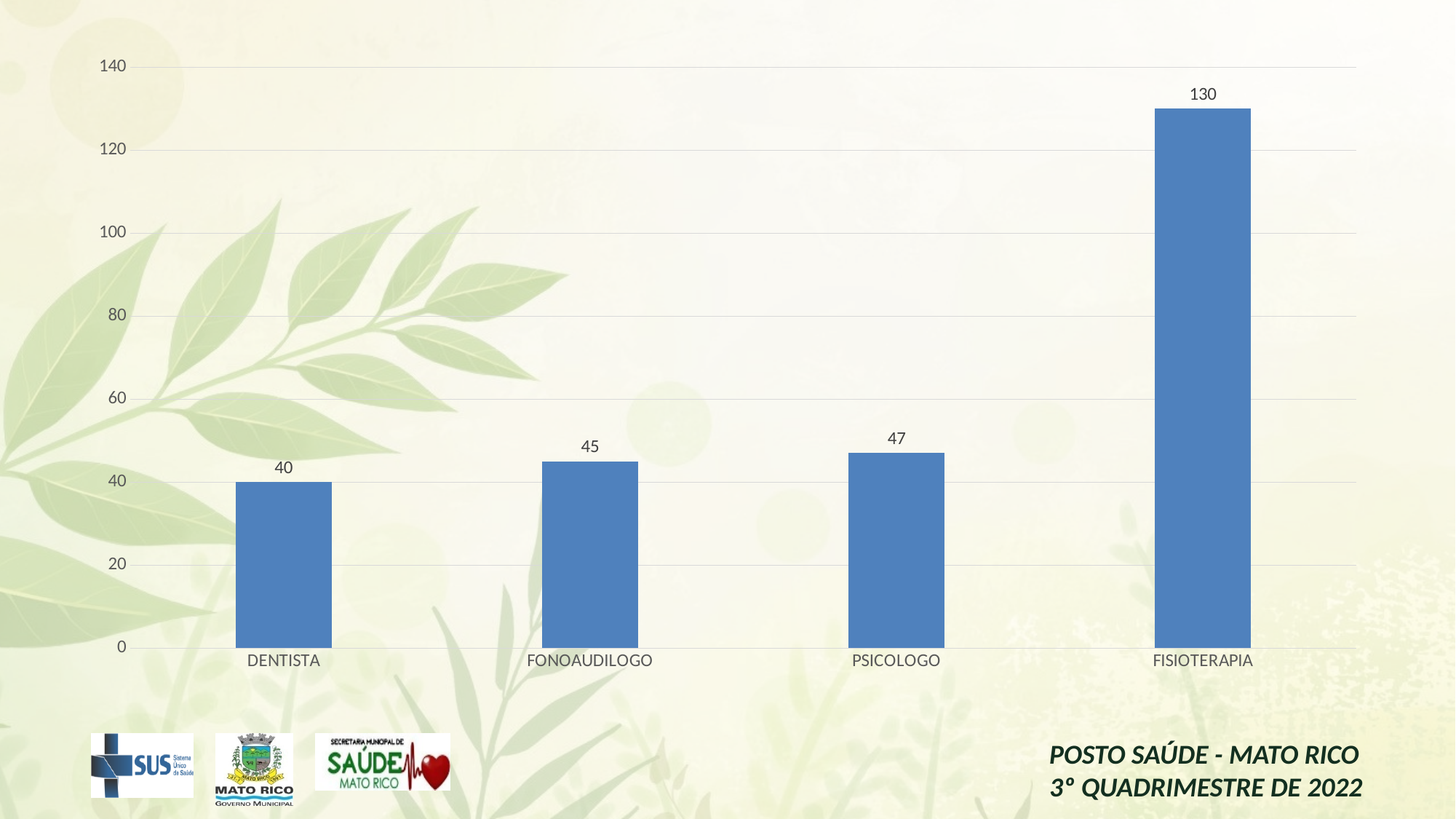
How many categories are shown on the x axis? 4 What is the difference between the values for FISIOTERAPIA and PSICOLOGO? 83 What is the difference between the values for FONOAUDILOGO and DENTISTA? 5 Which is larger, the value for FISIOTERAPIA or the value for DENTISTA? FISIOTERAPIA What kind of chart is shown on the slide? bar chart What is the value for DENTISTA? 40 What is the value for PSICOLOGO? 47 What is the value for FISIOTERAPIA? 130 Is the value for FISIOTERAPIA greater or less than 120? greater Which category has the lowest value? DENTISTA Which category has the highest value? FISIOTERAPIA What is the value for FONOAUDILOGO? 45